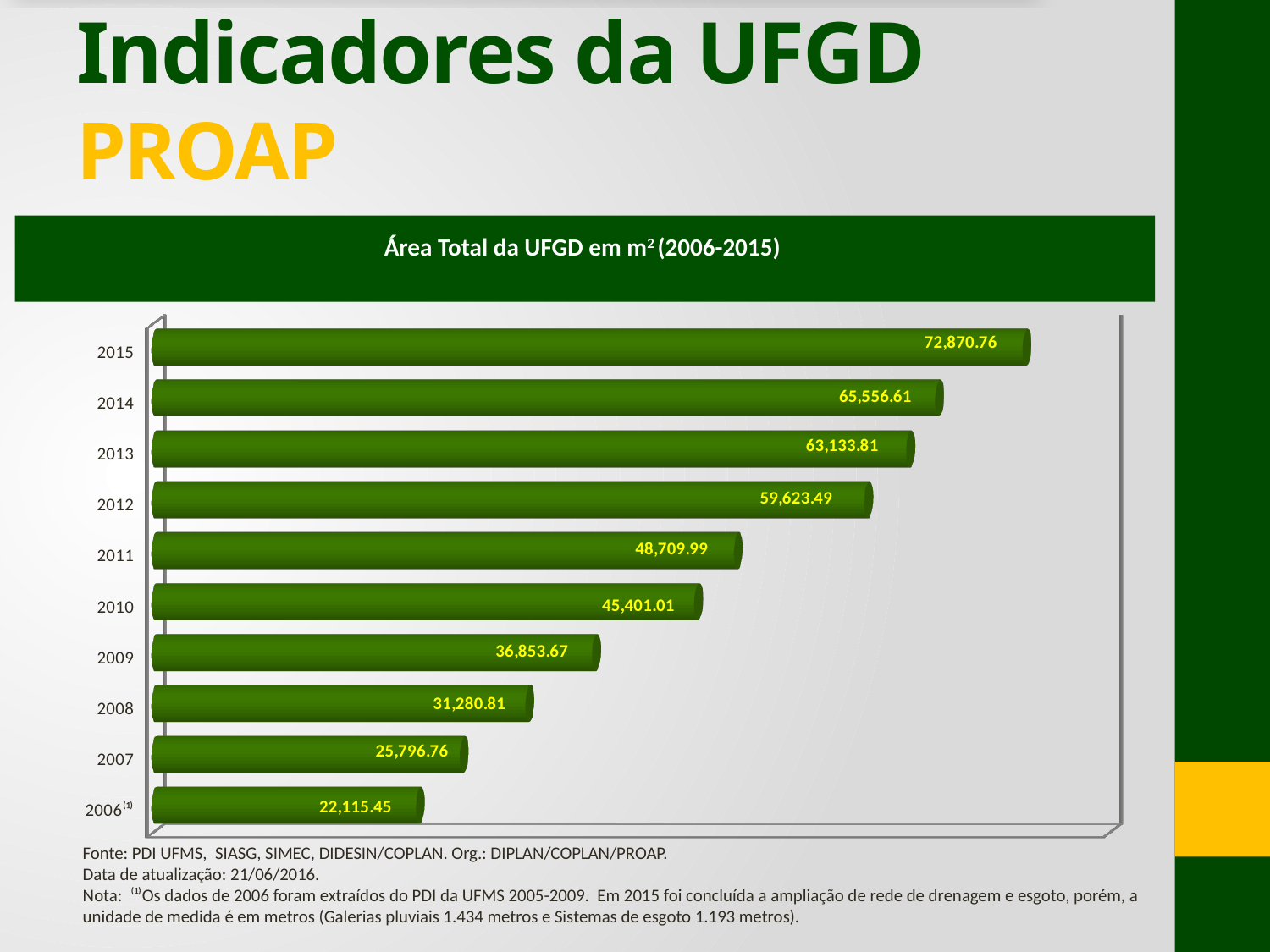
What is the difference between the values for 2015 and 2014? 7,314.15 Which is larger, the value for 2013 or the value for 2012? 2013 What is the value for 2008? 31,280.81 Do the values rise or fall from 2006 to 2015? Rise How many years are shown in the chart? 10 What is the value for 2015? 72,870.76 Which year has the lowest value? 2006 What kind of chart is this? Bar chart Which year has the highest value? 2015 What is the value for 2010? 45,401.01 What is the difference between the values for 2012 and 2011? 10,913.50 What is the value for 2006? 22,115.45